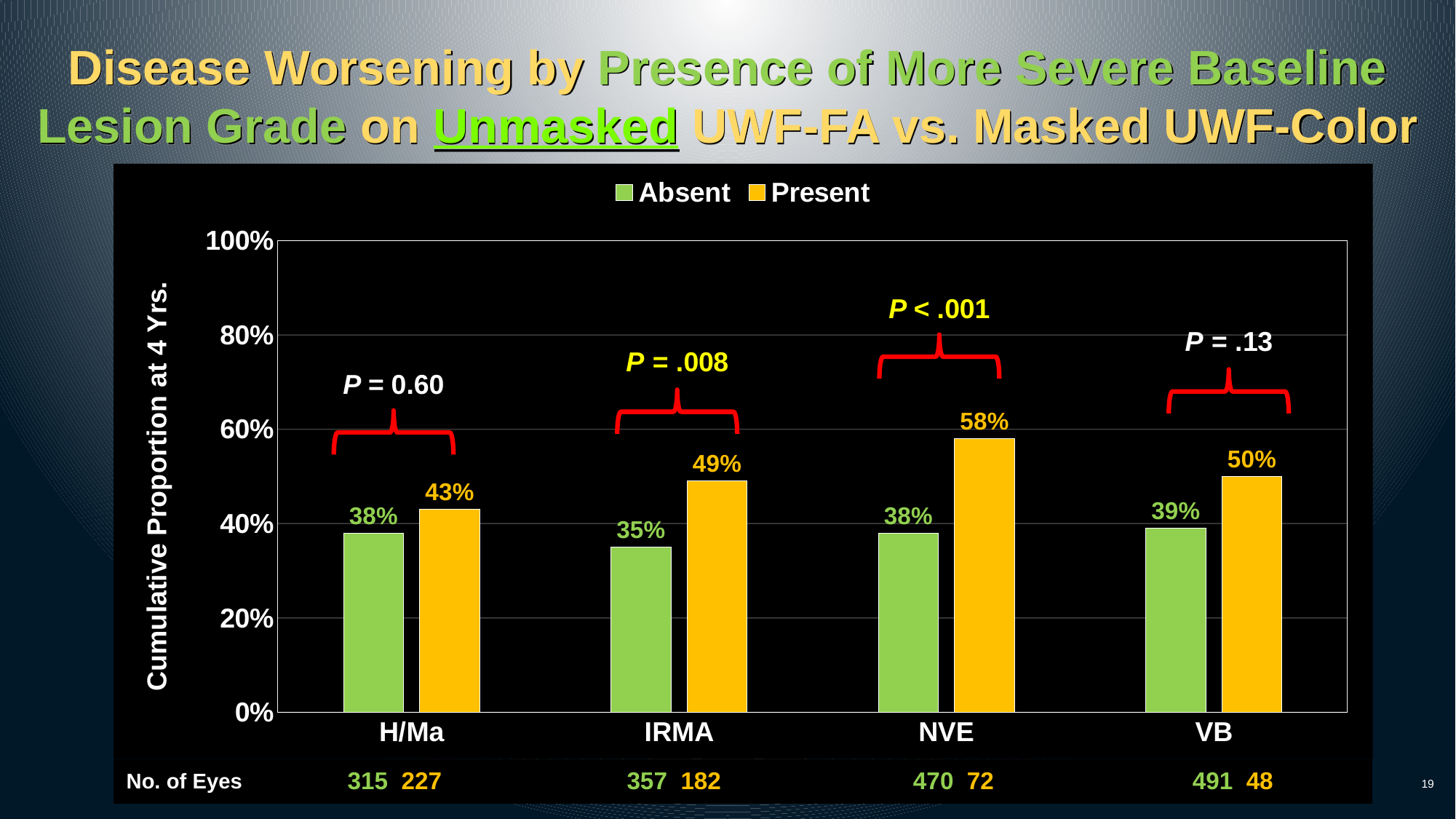
What is the value for Present in the VB category? 50% How many series does the legend list? 2 What is the value for Present in the NVE category? 58% How many categories are shown on the x axis? 4 What is the P value shown above the NVE bars? P < .001 What is the value for Absent in the IRMA category? 35% Which is larger for IRMA, the Absent value or the Present value? Present Which category has the highest Present value? NVE What is the difference between the Present and Absent values for H/Ma? 5% Which category has the lowest Absent value? IRMA What is the difference between the Present and Absent values for NVE? 20% What kind of chart is shown on the slide? Bar chart